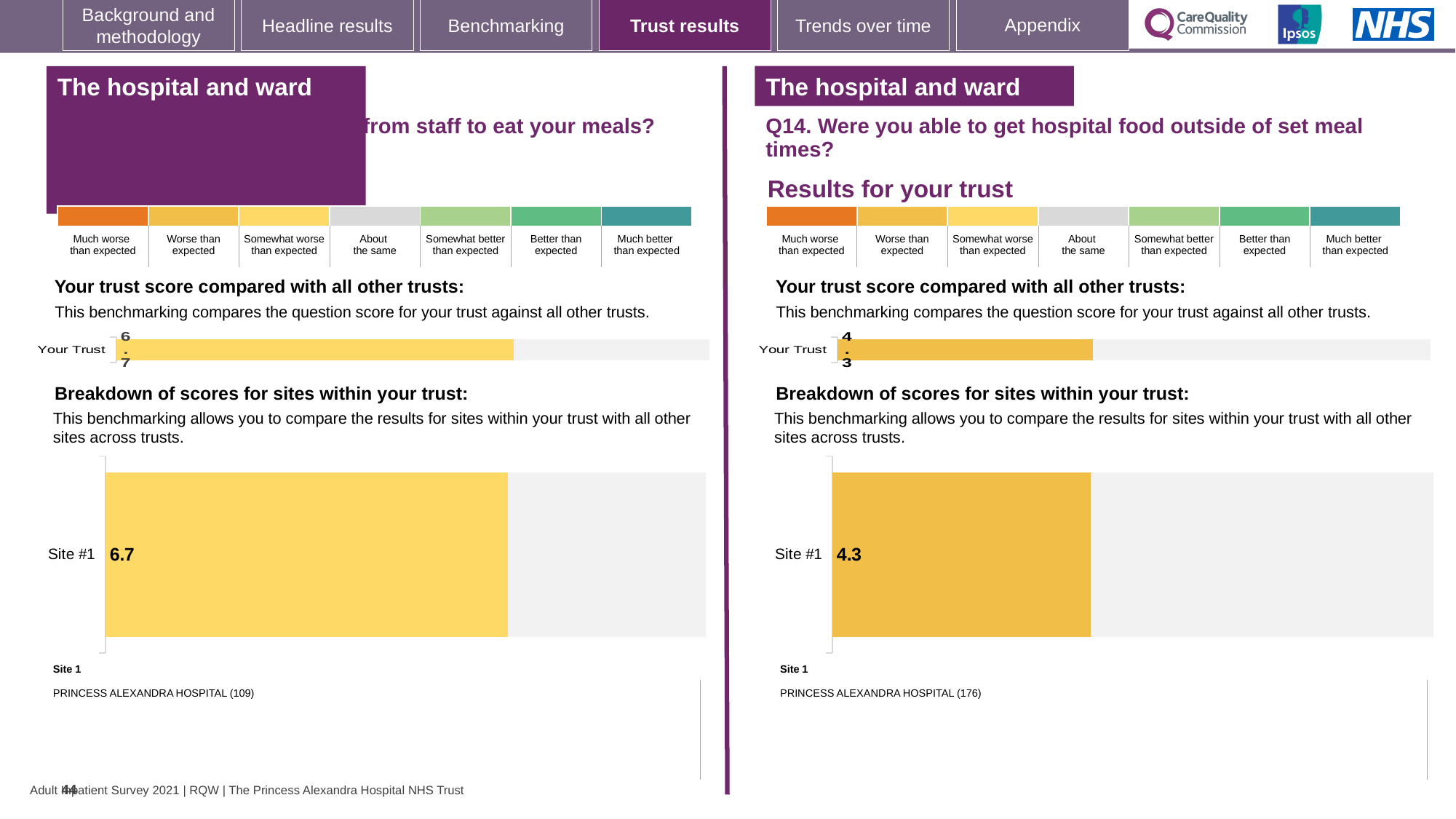
Is the Your Trust score on the right-hand side of the slide (Q14) the same as the Site #1 score in the right-hand breakdown chart? Yes, both are 4.3 In the right-hand breakdown chart (Q14), which site is Site #1 and how many respondents does it have? Princess Alexandra Hospital (176) In the left-hand 'Breakdown of scores for sites within your trust' chart, what is the score for Site #1? 6.7 What kind of chart is used to show the Site #1 score in the left-hand breakdown section? Bar chart In the right-hand 'Breakdown of scores for sites within your trust' chart (Q14), what is the score for Site #1? 4.3 How many sites are shown in the right-hand 'Breakdown of scores for sites within your trust' chart? 1 On the left-hand side of the slide, what is the score shown for Your Trust? 6.7 What is the difference between the Site #1 score in the left-hand breakdown chart and the Site #1 score in the right-hand breakdown chart? 2.4 On the right-hand side of the slide (Q14), what is the score shown for Your Trust? 4.3 In the left-hand breakdown chart, how many respondents are listed for Princess Alexandra Hospital (Site 1)? 109 Which is larger: the Site #1 score in the left-hand breakdown chart or the Site #1 score in the right-hand breakdown chart? Left-hand chart (6.7)